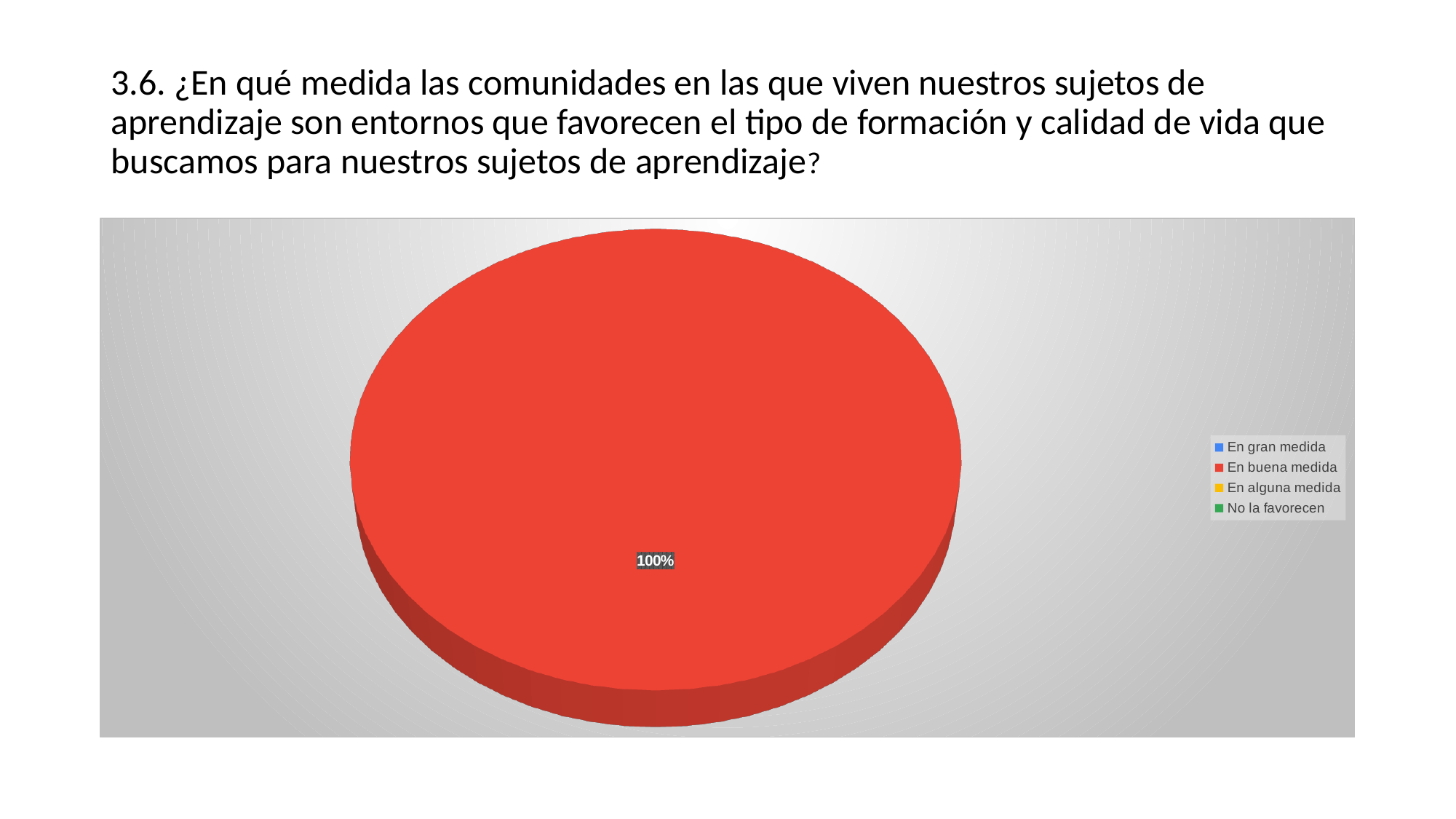
What is the data label printed on the pie? 100% What share of the pie does "En buena medida" hold? 100% Which legend entry is shown in red? En buena medida Which category makes up the entire pie? En buena medida What kind of chart is shown on the slide? pie chart Which legend entry is shown in green? No la favorecen How many categories does the legend list? 4 Is the share for "En buena medida" greater or less than 50%? greater Which is larger, the share for "En buena medida" or the share for "En gran medida"? En buena medida